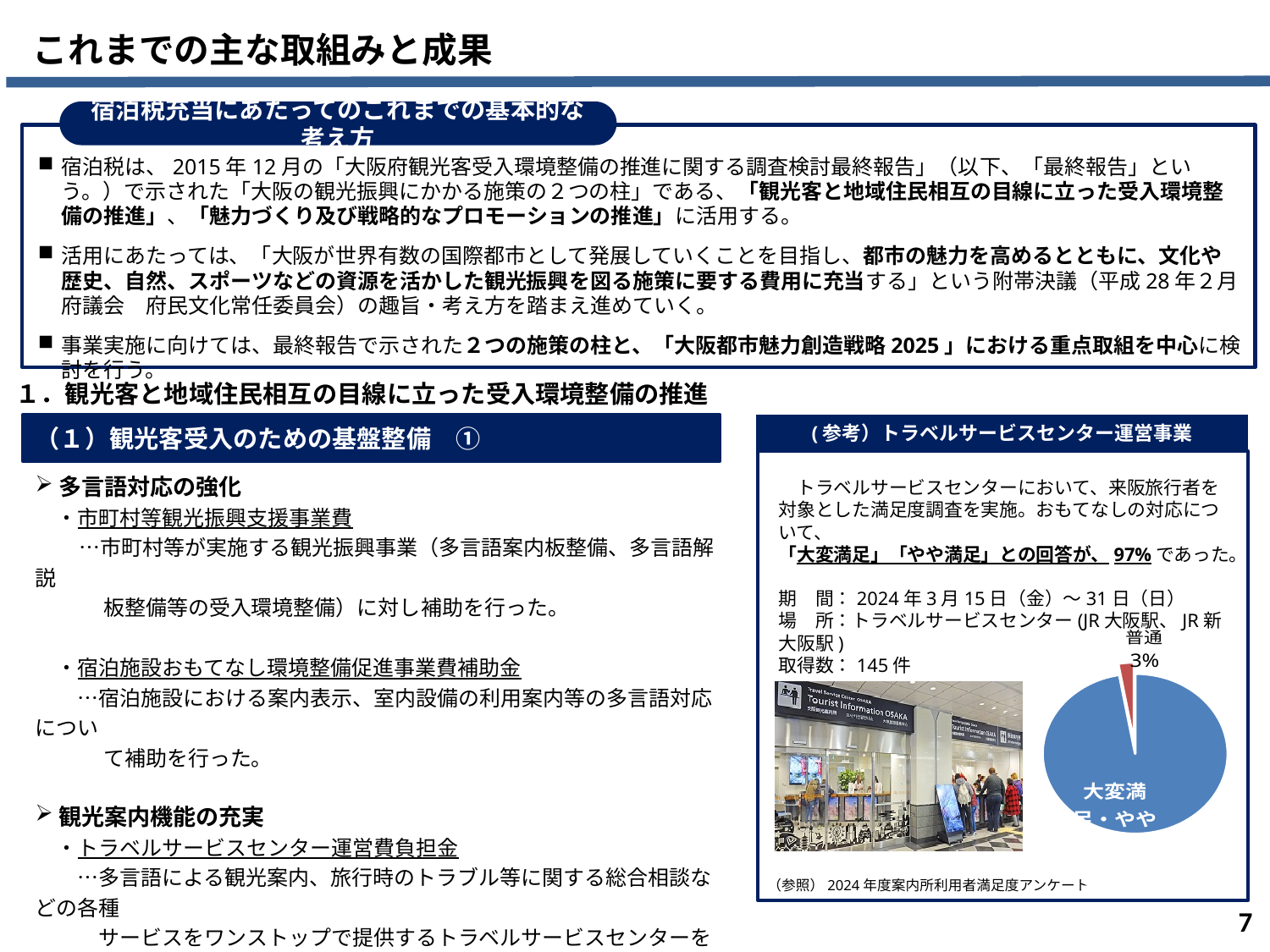
What colour is the 普通 slice in the pie chart? red Which is larger in the pie chart, 普通 or 大変満足・やや満足? 大変満足・やや満足 What share of the pie chart is taken by the 大変満足・やや満足 slice? 97% How many slices does the pie chart have? 2 Which slice of the pie chart is the largest? 大変満足・やや満足 What percentage does the 普通 slice of the pie chart represent? 3% Which slice of the pie chart is the smallest? 普通 What survey is cited as the source of the pie chart? 2024年度案内所利用者満足度アンケート What is the difference in percentage points between the 大変満足・やや満足 slice and the 普通 slice? 94 What kind of chart is shown on the slide? pie chart